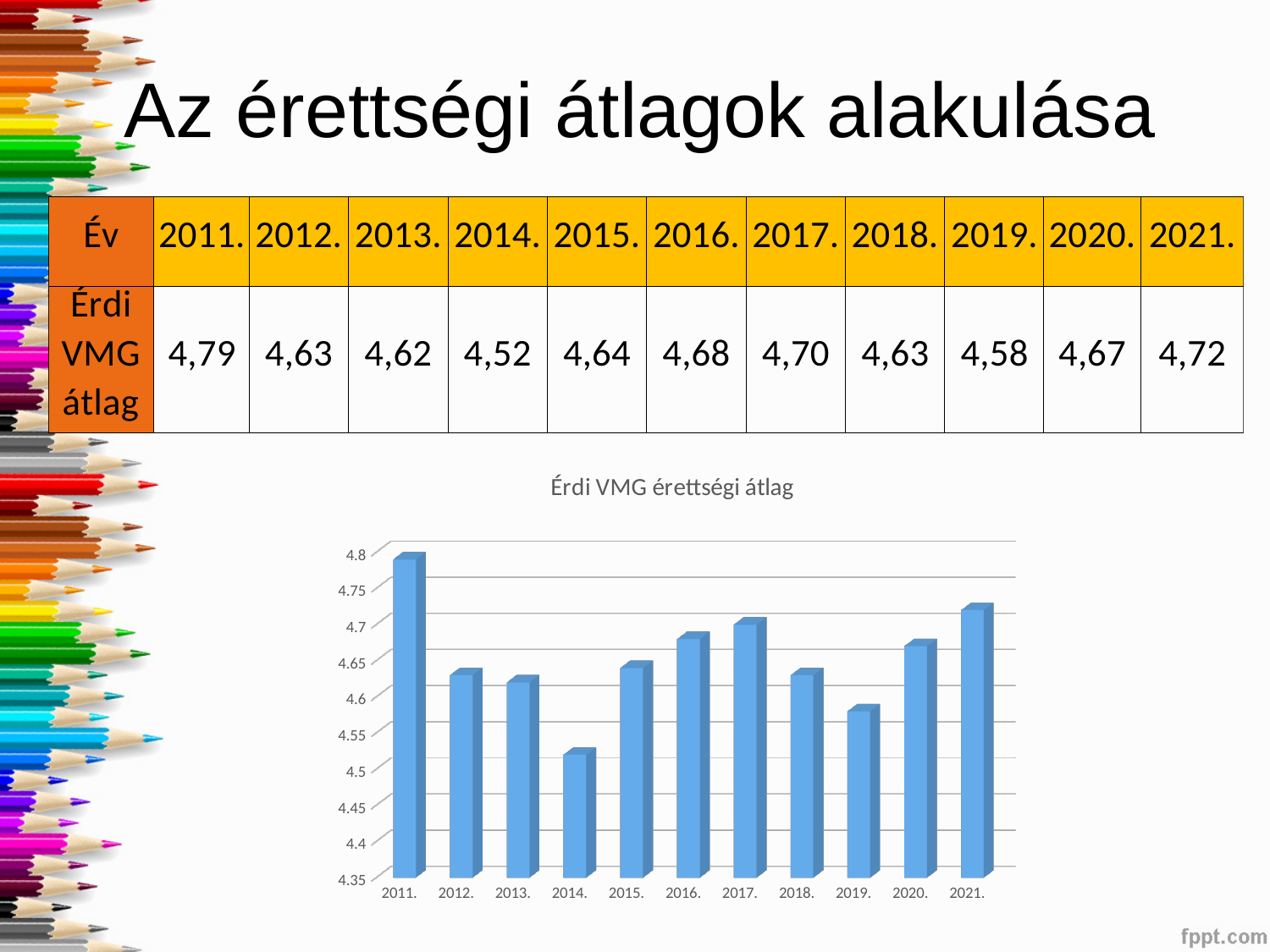
What is the Érdi VMG átlag value for 2021 as printed in the table? 4,72 Is the bar for 2019 greater or less than 4.6? less Which year has the lowest bar in the chart? 2014. Is the bar for 2017 greater or less than 4.65? greater What is the Érdi VMG átlag value for 2011 as printed in the table? 4,79 How many years are plotted on the x axis of the chart? 11 Which is larger, the value for 2016 or the value for 2019? 2016. What is the difference between the 2011 value and the 2014 value, using the values printed in the table? 0,27 What is the Érdi VMG átlag value for 2014 as printed in the table? 4,52 What type of chart is shown on the slide? bar chart What is the title of the chart? Érdi VMG érettségi átlag Which year has the highest bar in the chart? 2011.